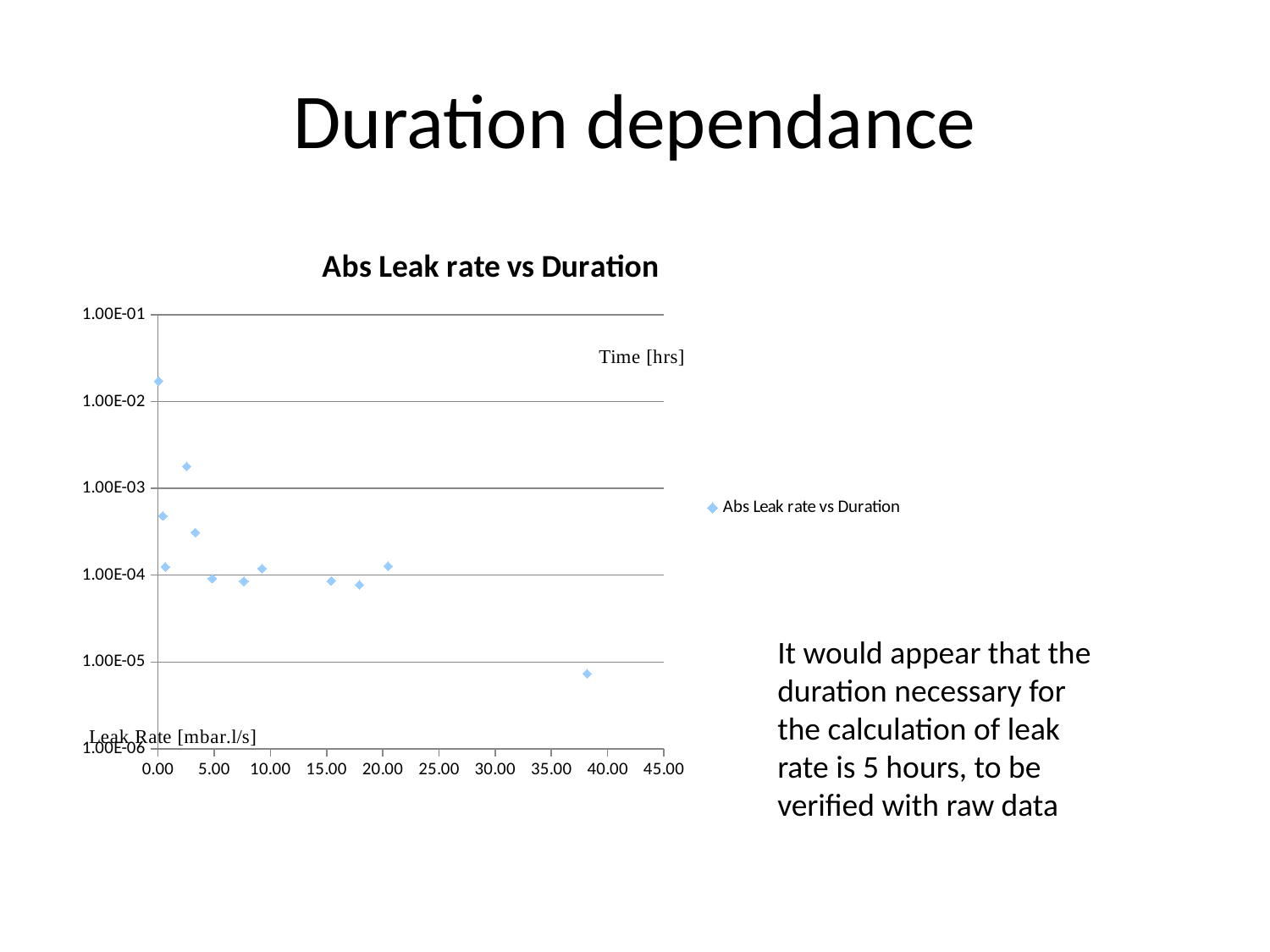
What is the label of the x axis? Time [hrs] Do the leak rate values generally rise or fall as time increases along the x axis? fall Is the leak rate of the point at 0 hours greater or less than 1.00E-02? greater Is the leak rate of the point at about 2.5 hours greater or less than 1.00E-03? greater Is the leak rate of the point at about 38 hours greater or less than 1.00E-05? less What kind of chart is shown on the slide? scatter chart Which has the larger leak rate: the point at 0 hours or the point at about 38 hours? the point at 0 hours What is the title of the chart? Abs Leak rate vs Duration How many series does the legend list? 1